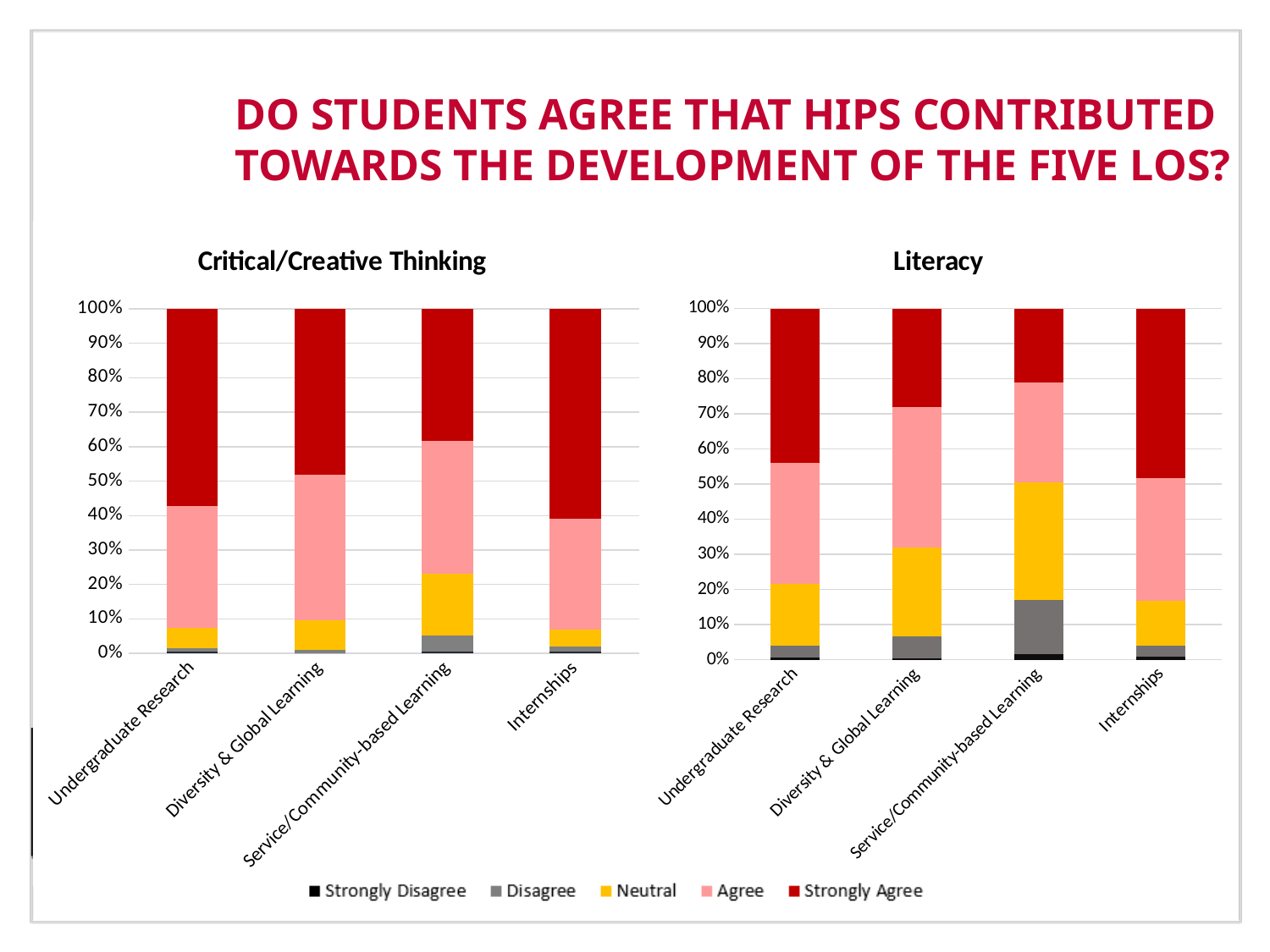
What kind of chart is the Critical/Creative Thinking chart? Stacked bar chart How many categories are shown on the x axis of the Literacy chart? 4 In the Literacy chart, which category has the smallest Strongly Agree segment? Service/Community-based Learning In the Literacy chart, which category has the largest Neutral segment? Service/Community-based Learning What is the title of the chart on the right? Literacy In the Literacy chart, is the Neutral segment larger for Service/Community-based Learning or for Internships? Service/Community-based Learning How many series does the legend list? 5 In the Literacy chart, which category has the largest Disagree segment? Service/Community-based Learning In the Critical/Creative Thinking chart, is the Strongly Agree share for Service/Community-based Learning greater or less than 50%? less In the Critical/Creative Thinking chart, which category has the smallest Strongly Agree segment? Service/Community-based Learning In the Critical/Creative Thinking chart, is the Strongly Agree segment larger for Undergraduate Research or for Service/Community-based Learning? Undergraduate Research Which legend entry is shown in dark red? Strongly Agree